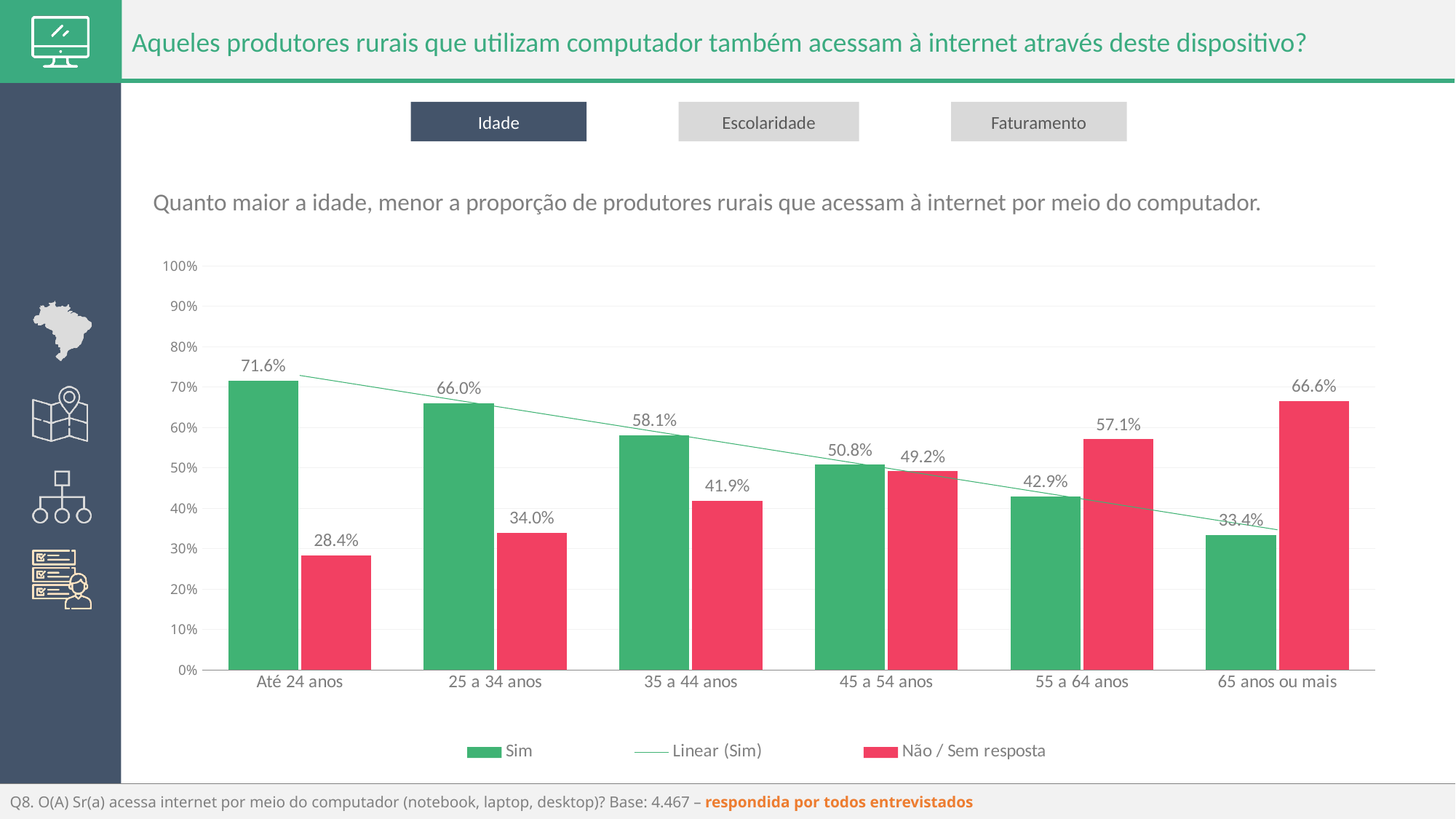
How many entries does the legend list? 3 For the "55 a 64 anos" category, which is larger: "Sim" or "Não / Sem resposta"? Não / Sem resposta What is the value of "Sim" for the "65 anos ou mais" category? 33.4% What is the difference between the "Sim" values for "Até 24 anos" and "65 anos ou mais"? 38.2 percentage points Which age category has the highest "Sim" value? Até 24 anos What is the value of "Não / Sem resposta" for the "45 a 54 anos" category? 49.2% What is the value of "Sim" for the "Até 24 anos" category? 71.6% How many age categories are shown on the x axis? 6 Which age category has the lowest "Não / Sem resposta" value? Até 24 anos Is the "Sim" value for "35 a 44 anos" greater or less than 50%? greater Do the "Sim" values rise or fall as age increases along the x axis? Fall What kind of chart is shown on the slide? Bar chart